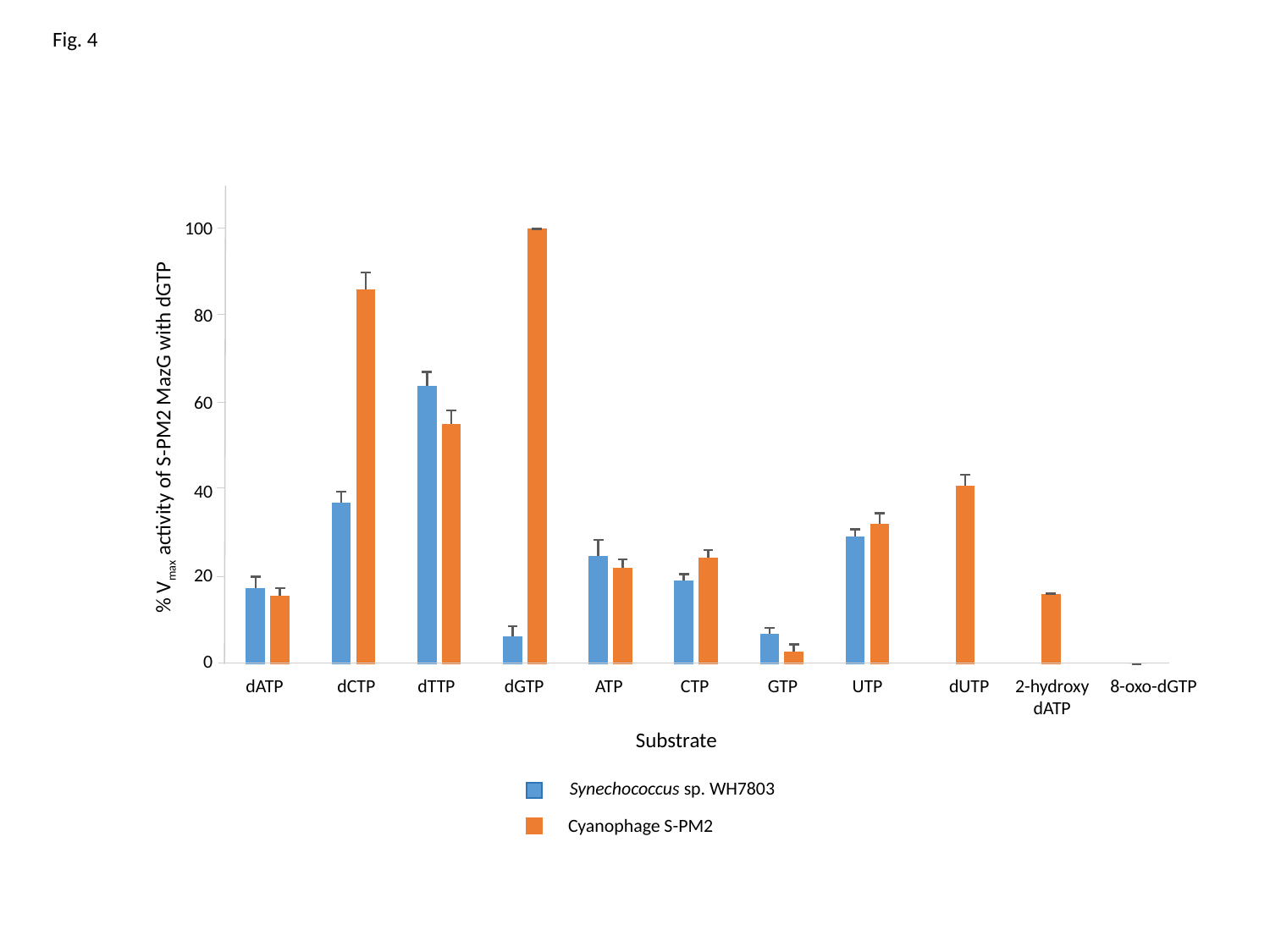
For dTTP, which series has the larger value, Synechococcus sp. WH7803 or Cyanophage S-PM2? Synechococcus sp. WH7803 For which substrate is the Cyanophage S-PM2 value highest? dGTP What is the Cyanophage S-PM2 value for dGTP? 100 For which substrate is the Synechococcus sp. WH7803 value highest? dTTP Is the Cyanophage S-PM2 value for dUTP greater or less than 20? greater For GTP, which series has the larger value, Synechococcus sp. WH7803 or Cyanophage S-PM2? Synechococcus sp. WH7803 Is the Cyanophage S-PM2 value for dCTP greater or less than 80? greater Is the Synechococcus sp. WH7803 value for dCTP greater or less than 40? less How many series does the legend list? 2 What is the x-axis title of the chart? Substrate How many substrate categories are shown on the x axis? 11 What kind of chart is shown on the slide? bar chart